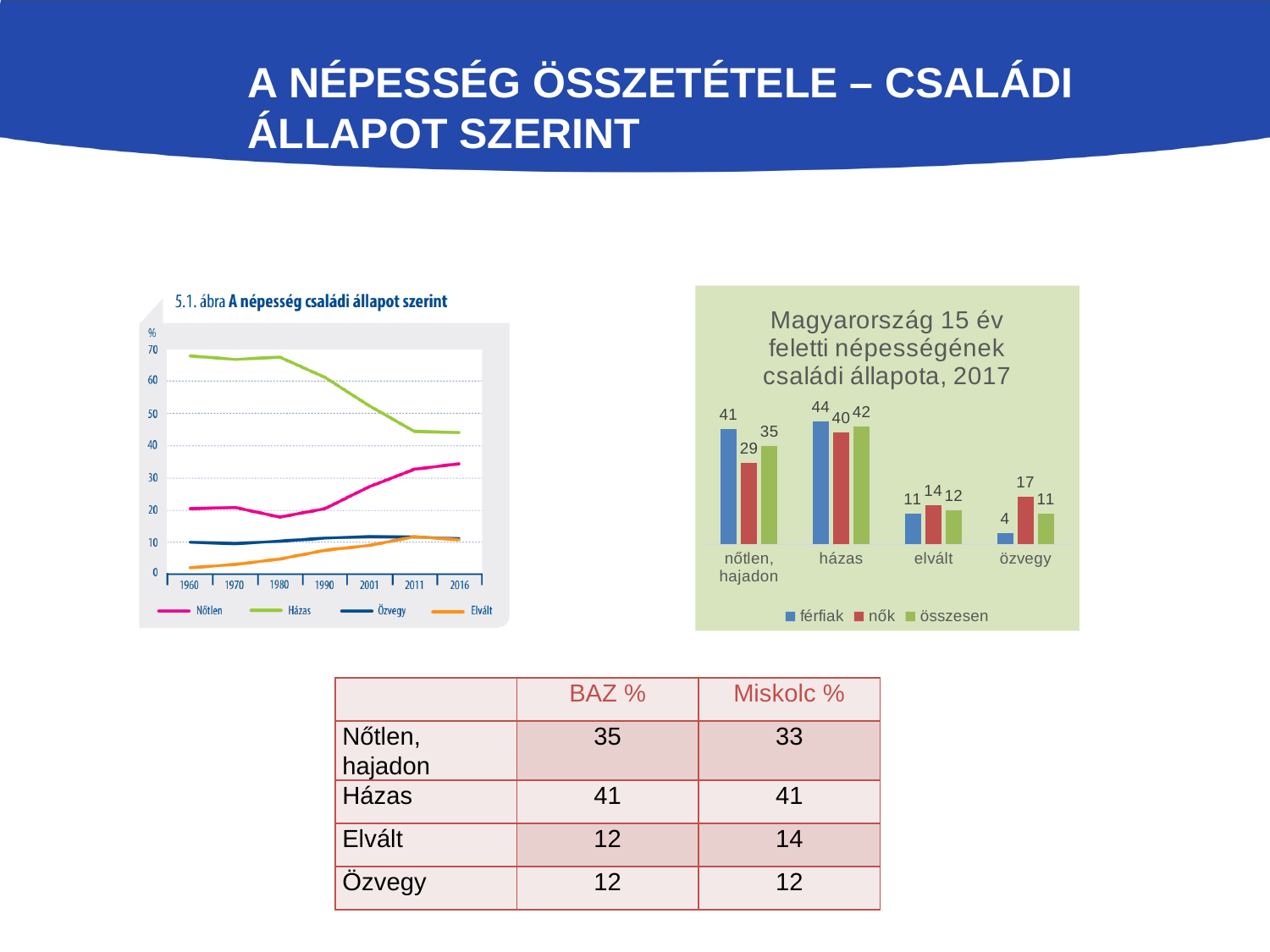
In the line chart on the left, is the value for Házas in 1960 greater or less than 60? greater In the bar chart on the right, is the value for nők or férfiak larger in the elvált category? nők In the bar chart on the right, what is the összesen value for nőtlen, hajadon? 35 How many categories are shown on the x axis of the bar chart on the right? 4 How many series does the legend of the bar chart on the right list? 3 In the line chart on the left, does the Házas series rise or fall from 1960 to 2016? fall In the bar chart on the right, which category has the highest összesen value? házas In the bar chart on the right, which category has the lowest value for férfiak? özvegy In the bar chart titled "Magyarország 15 év feletti népességének családi állapota, 2017", what is the value for férfiak in the házas category? 44 What kind of chart is the chart on the left titled "A népesség családi állapot szerint"? line chart In the bar chart on the right, what is the difference between the férfiak and nők values in the nőtlen, hajadon category? 12 In the bar chart on the right, what is the value for nők in the özvegy category? 17